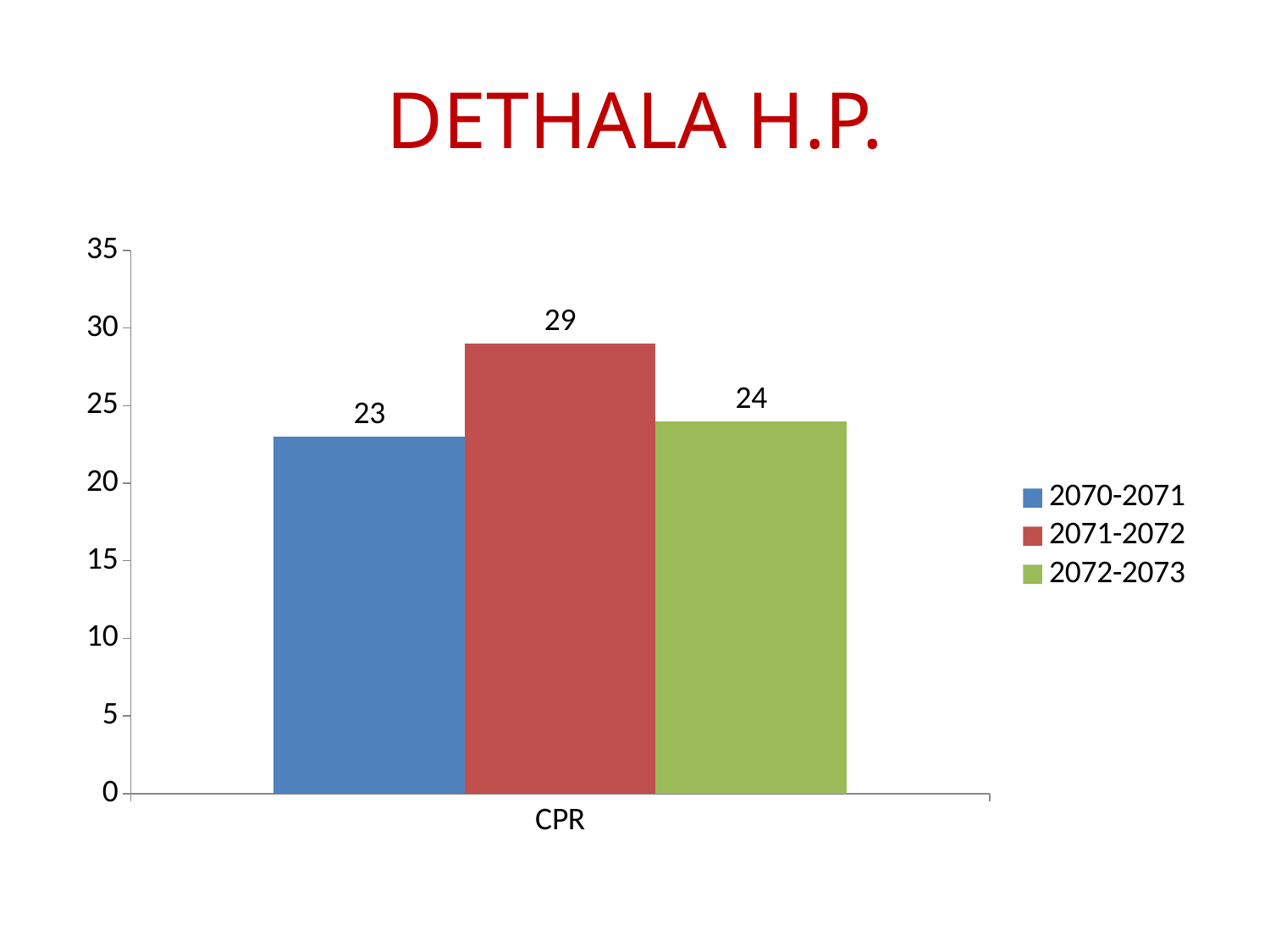
What is the difference between the CPR values for 2071-2072 and 2070-2071? 6 How many series does the legend list? 3 Which is larger, the CPR value for 2072-2073 or for 2070-2071? 2072-2073 What kind of chart is shown on the slide? bar chart Is the CPR value for 2071-2072 greater or less than 25? greater What is the CPR value for 2070-2071? 23 What is the title of the slide? DETHALA H.P. What is the CPR value for 2071-2072? 29 What is the difference between the CPR values for 2071-2072 and 2072-2073? 5 Which year has the highest CPR value? 2071-2072 Which year has the lowest CPR value? 2070-2071 What is the CPR value for 2072-2073? 24